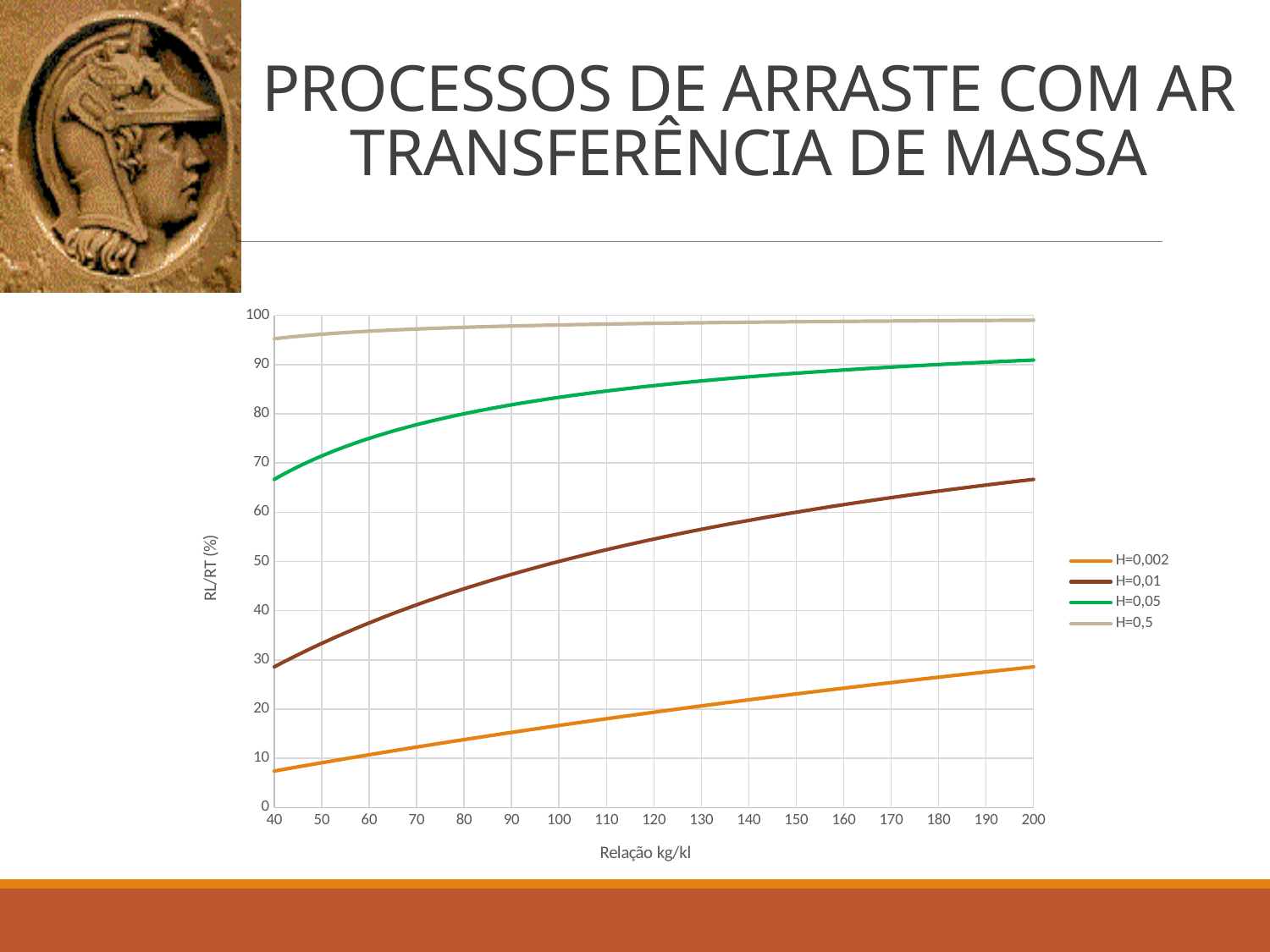
What is the title of the x axis? Relação kg/kl Is the value for H=0,01 at Relação kg/kl = 200 greater or less than 60? greater How many series does the legend list? 4 What is the title of the y axis? RL/RT (%) What kind of chart is shown on the slide? line chart Which series has the highest value at Relação kg/kl = 200? H=0,5 At Relação kg/kl = 100, which is larger: the value for H=0,05 or the value for H=0,01? H=0,05 Is the value for H=0,002 at Relação kg/kl = 200 greater or less than 30? less Do the values of the H=0,002 series rise or fall as Relação kg/kl increases from 40 to 200? rise Which series has the lowest value at Relação kg/kl = 40? H=0,002 Is the value for H=0,002 at Relação kg/kl = 40 greater or less than 10? less